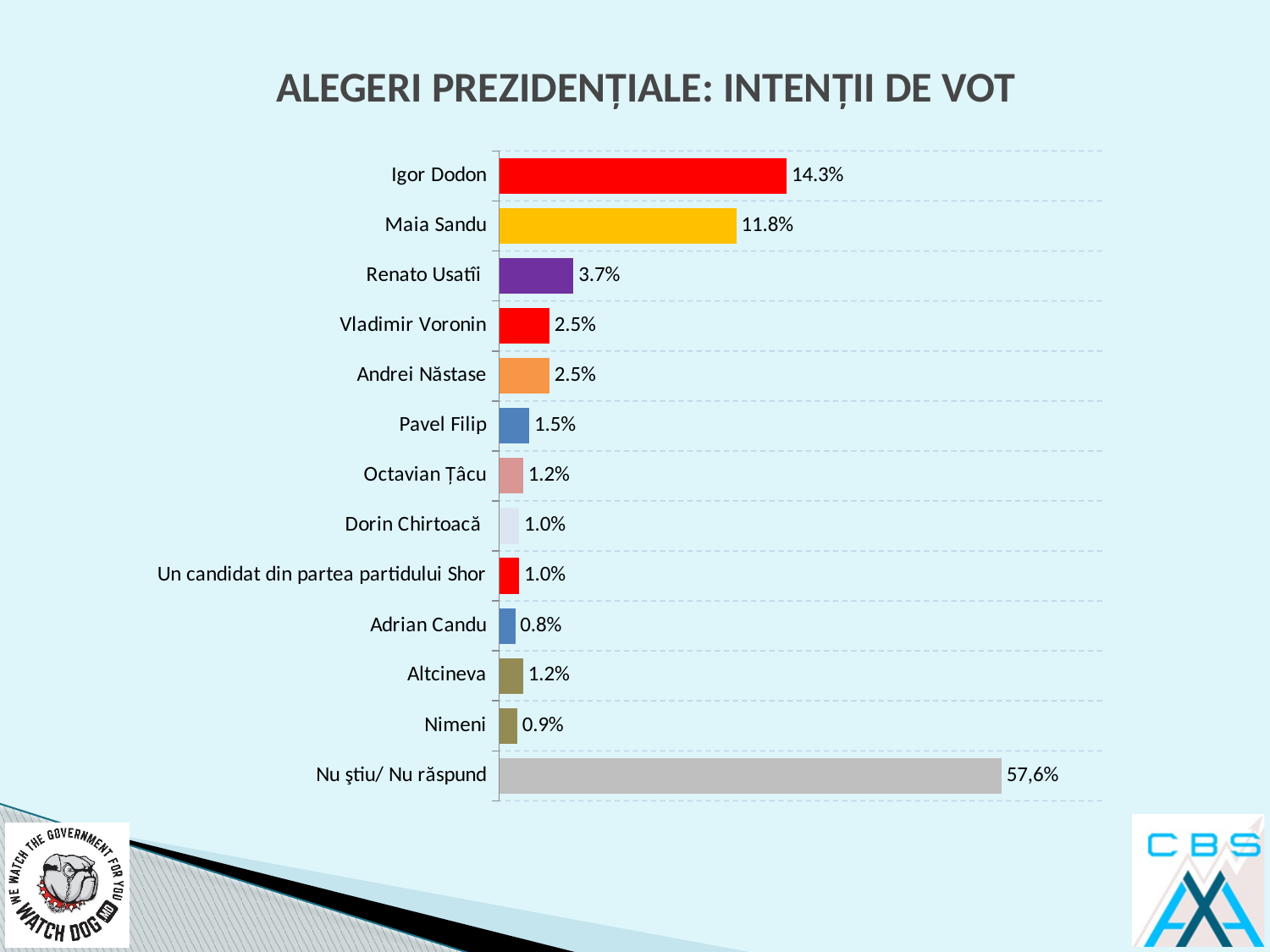
Which is larger, the value for Renato Usatîi or the value for Vladimir Voronin? Renato Usatîi What is the value for Igor Dodon? 14.3% Which category has the highest value? Nu știu/ Nu răspund What is the value for Maia Sandu? 11.8% What is the value for Renato Usatîi? 3.7% What is the difference between the values for Igor Dodon and Maia Sandu? 2.5 percentage points What is the title of the chart? ALEGERI PREZIDENȚIALE: INTENȚII DE VOT Which category has the lowest value? Adrian Candu What is the value for Pavel Filip? 1.5% What is the value for Nu știu/ Nu răspund? 57,6% How many categories are shown in the chart? 13 What kind of chart is shown on the slide? Bar chart